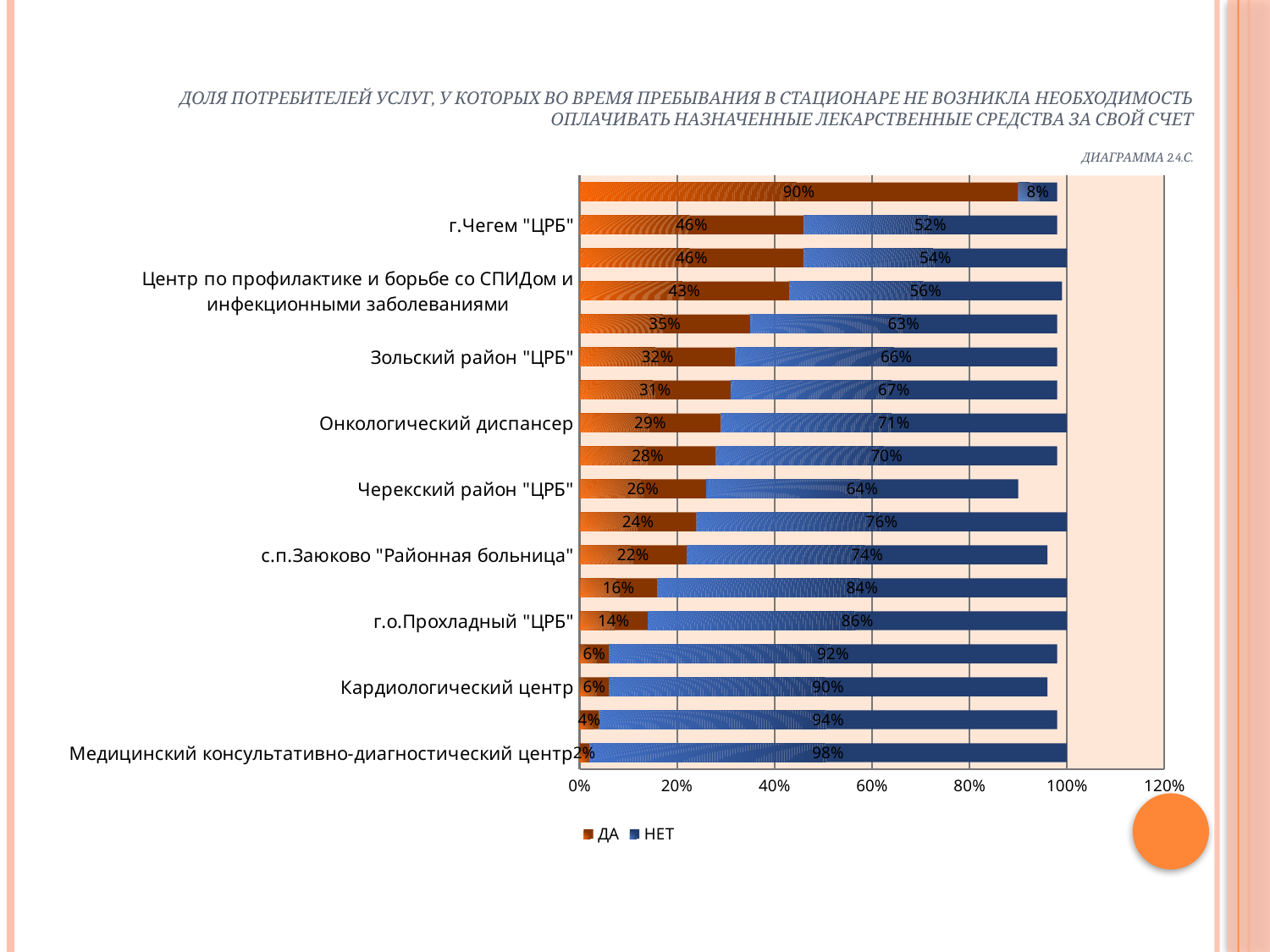
What is the ДА value for Кардиологический центр? 6% What is the НЕТ value for Медицинский консультативно-диагностический центр? 98% What is the difference between the НЕТ and ДА values for Черекский район "ЦРБ"? 38 percentage points Which has the larger ДА value: Зольский район "ЦРБ" or с.п.Заюково "Районная больница"? Зольский район "ЦРБ" What is the ДА value for Зольский район "ЦРБ"? 32% Which category has the highest НЕТ value? Медицинский консультативно-диагностический центр What is the ДА value for г.Чегем "ЦРБ"? 46% What are the two series named in the legend? ДА and НЕТ Which category has the lowest ДА value? Медицинский консультативно-диагностический центр What is the НЕТ value for Онкологический диспансер? 71% What kind of chart is shown on the slide? Stacked bar chart How many series does the legend list? 2